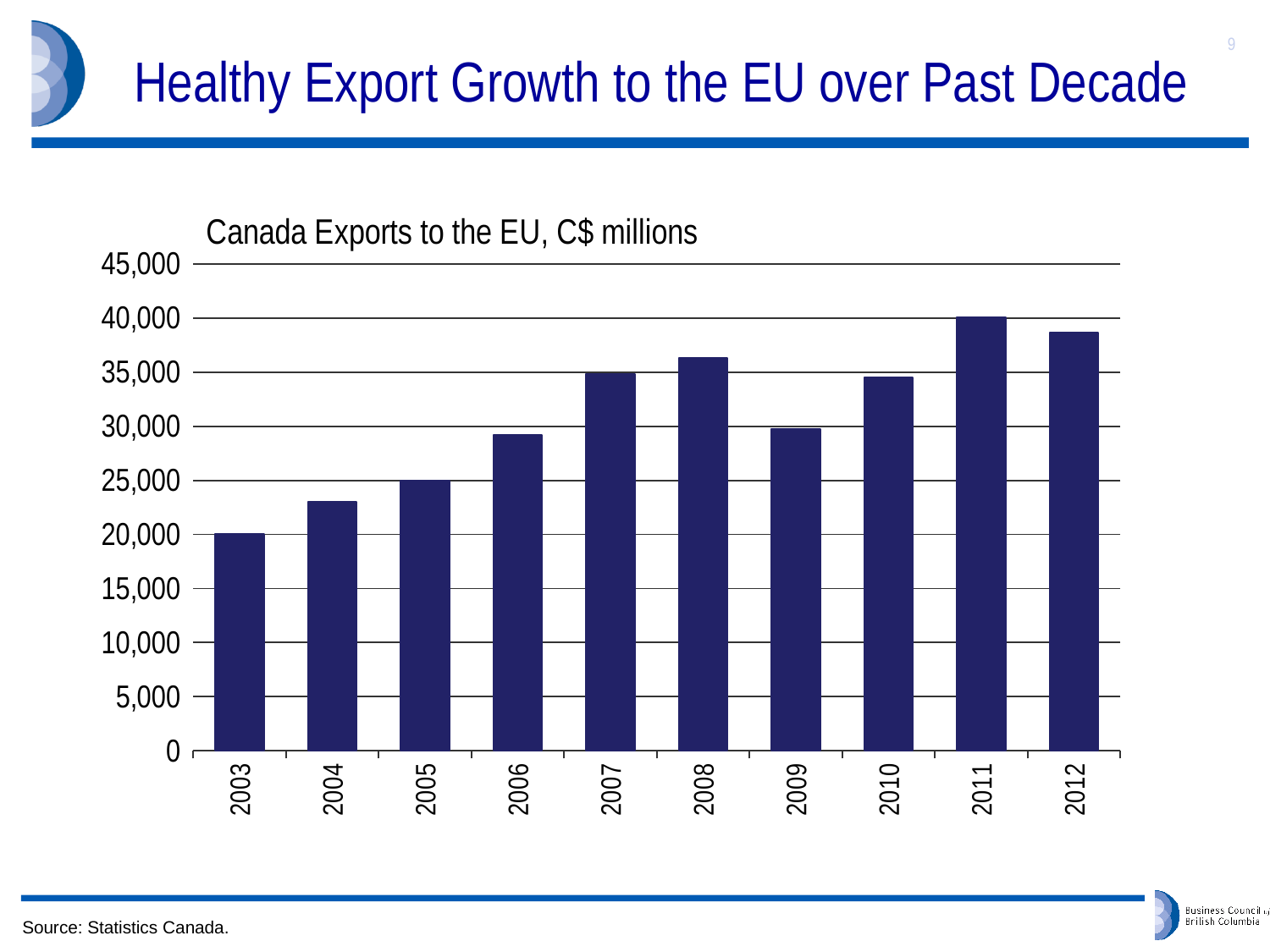
Is the value for 2006 greater or less than 25,000? greater Which year has the lowest value of Canada exports to the EU? 2003 Which year has the highest value of Canada exports to the EU? 2011 What is the title of the chart? Canada Exports to the EU, C$ millions Is the value for 2012 greater or less than 40,000? less Overall, do Canada's exports to the EU rise or fall from 2003 to 2012? Rise Which year has the larger value, 2008 or 2010? 2008 Is the value for 2004 greater or less than 25,000? less Which year has the larger value, 2011 or 2012? 2011 How many years are shown on the x axis of the chart? 10 What kind of chart is shown on the slide? Bar chart